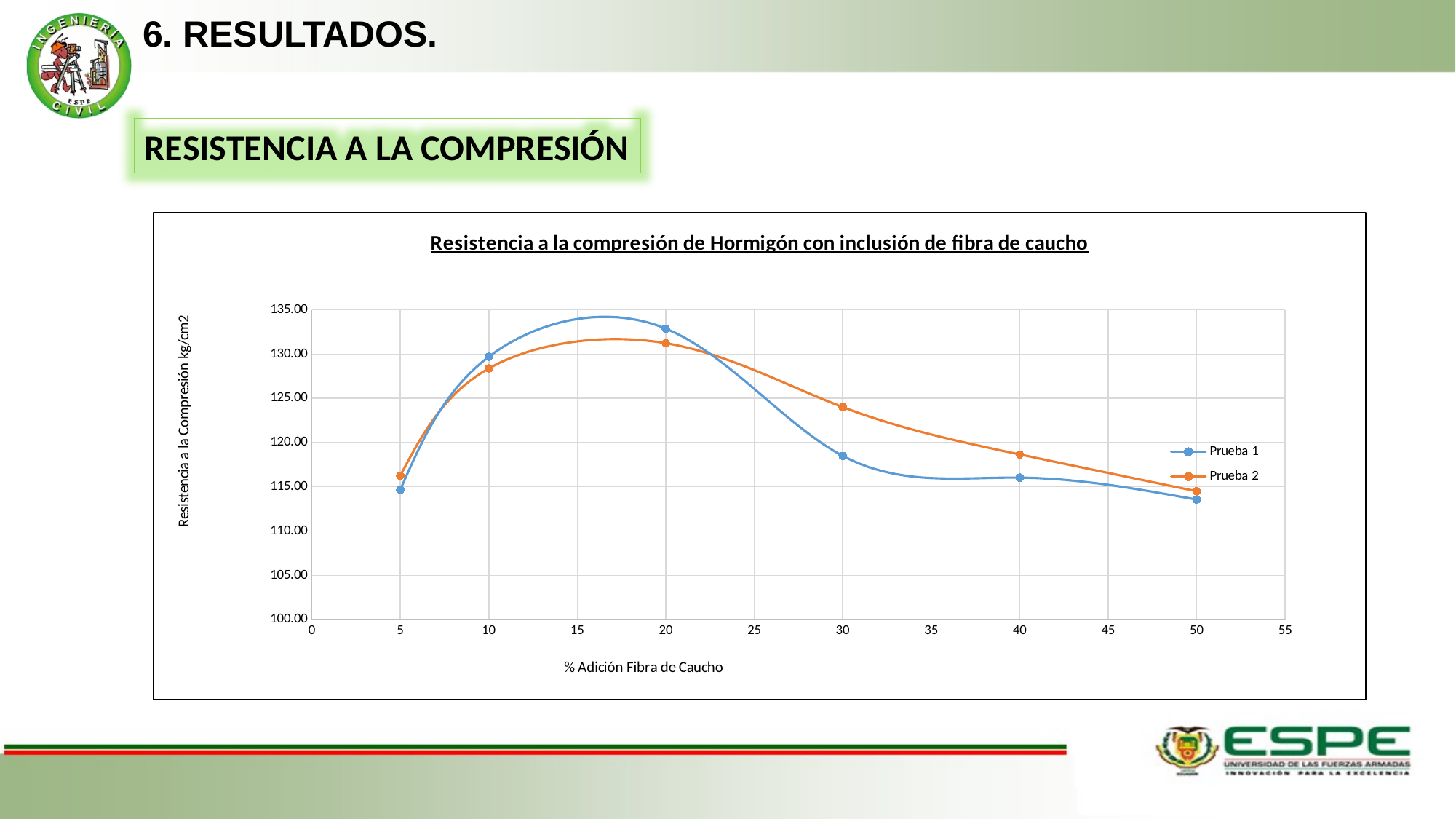
What kind of chart is shown on the slide? line chart Do the Prueba 1 values rise or fall from 20% to 50% Adición Fibra de Caucho? fall At which % Adición Fibra de Caucho does Prueba 1 reach its highest value? 20 At which % Adición Fibra de Caucho does Prueba 2 reach its highest value? 20 Is the value for Prueba 1 at 20% Adición Fibra de Caucho greater or less than 130.00? greater Is the value for Prueba 2 at 30% Adición Fibra de Caucho greater or less than 125.00? less What is the title of the x axis? % Adición Fibra de Caucho At 30% Adición Fibra de Caucho, which series has the larger value, Prueba 1 or Prueba 2? Prueba 2 What is the title of the y axis? Resistencia a la Compresión kg/cm2 How many series does the legend list? 2 How many data points are plotted for the Prueba 1 series? 6 At which % Adición Fibra de Caucho does Prueba 1 have its lowest value? 50